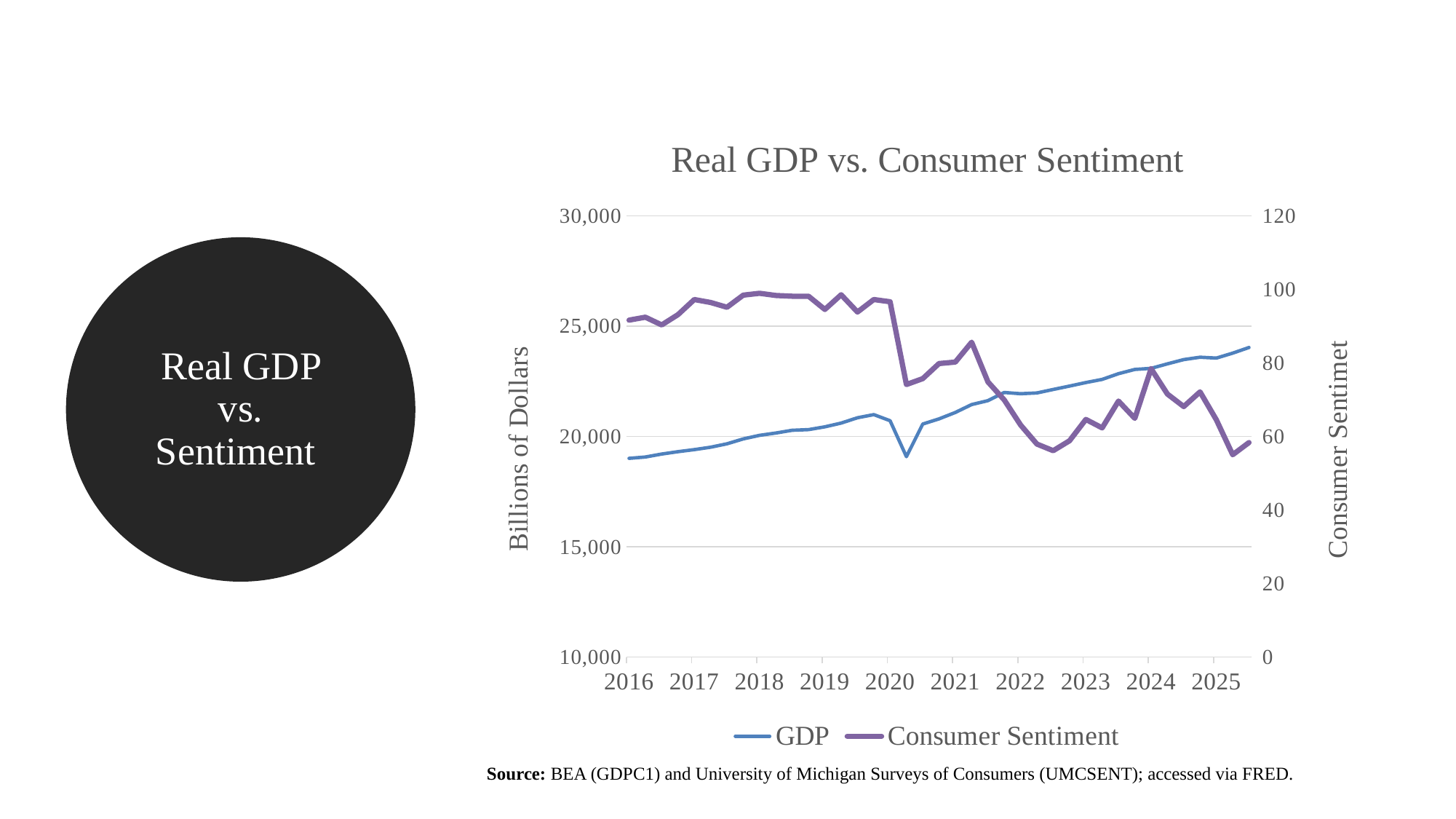
How many year labels are shown on the x axis? 10 Does the Consumer Sentiment line overall rise or fall from 2016 to 2025? Fall What is the label on the left vertical axis? Billions of Dollars Is the Consumer Sentiment value at 2018 greater or less than 80? greater How many series does the legend list? 2 Is the GDP value at 2016 greater or less than 20,000? less Does the GDP line overall rise or fall from 2016 to 2025? Rise Is the GDP value at 2025 greater or less than 25,000? less What kind of chart is shown on the slide? Line chart What is the title of the chart? Real GDP vs. Consumer Sentiment